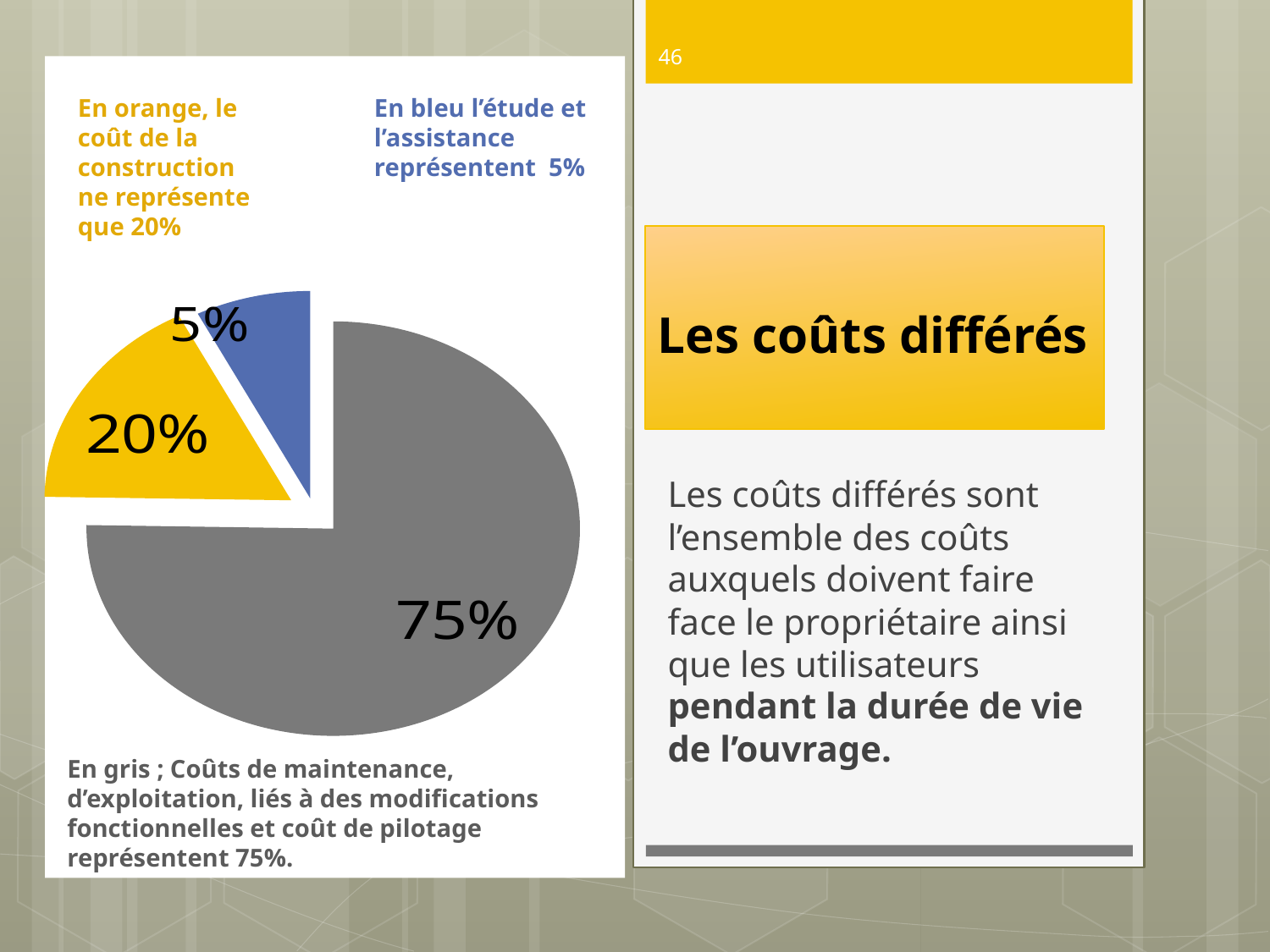
Which slice of the pie chart is the largest? 75% (gray) What is the difference between the orange slice and the blue slice? 15% Which slice of the pie chart is the smallest? 5% (blue) According to the slide text, what colour represents the cost of construction in the pie chart? orange How many slices does the pie chart have? 3 What is the difference between the gray slice and the orange slice? 55% What kind of chart is shown on the slide? pie chart According to the slide text, what does the blue slice of the pie represent? l'étude et l'assistance What share of the pie does the gray slice represent? 75% What share of the pie does the blue slice (study and assistance) represent? 5% What share of the pie does the orange slice (construction cost) represent? 20% Which is larger, the orange slice or the blue slice? the orange slice